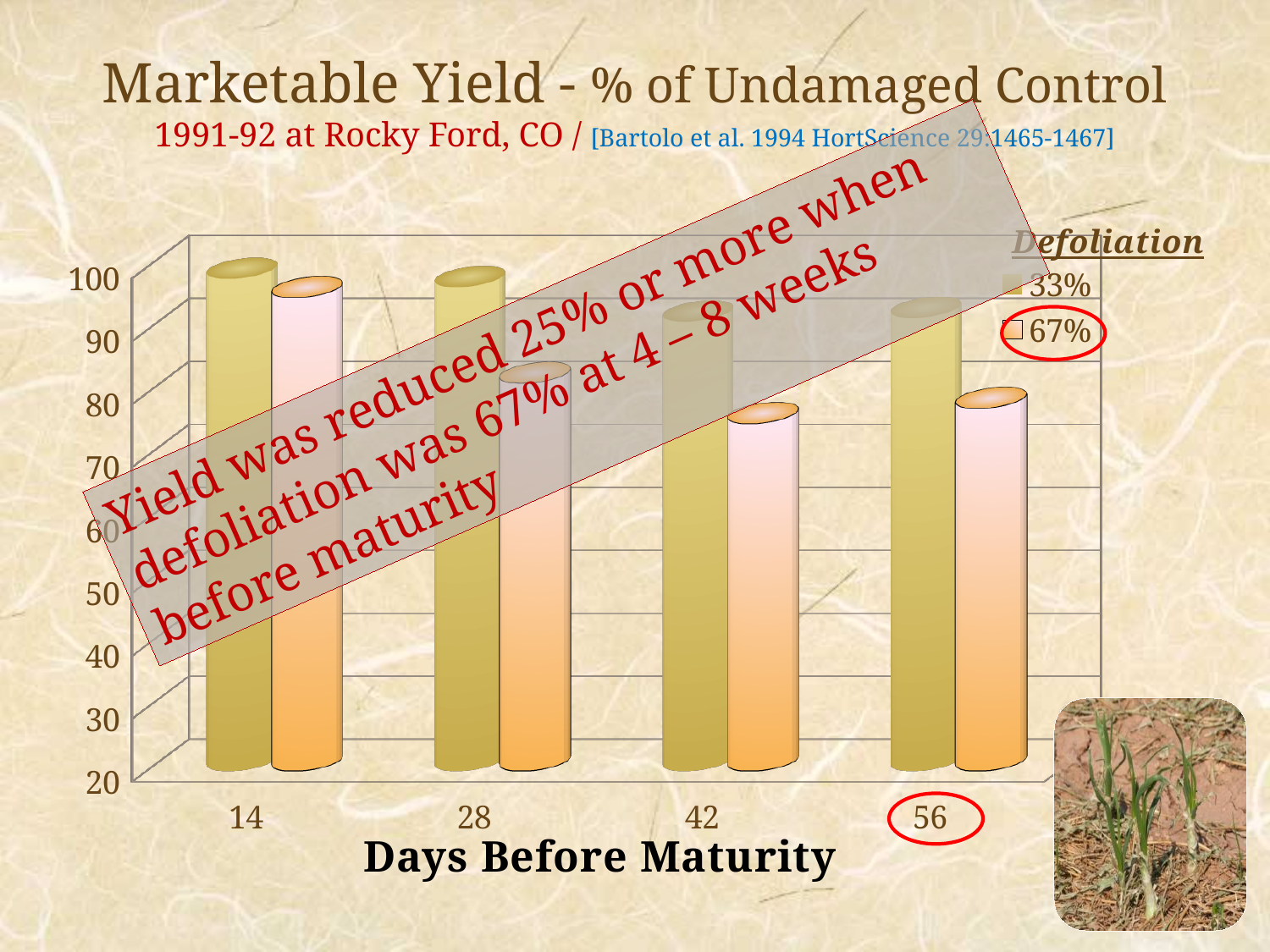
How many series does the Defoliation legend list? 2 Is the value for 67% defoliation at 42 days before maturity greater or less than 90? less For the 67% defoliation series, at which number of days before maturity is the yield highest? 14 At 28 days before maturity, which defoliation level has the higher marketable yield, 33% or 67%? 33% What kind of chart is shown on the slide? bar chart At 42 days before maturity, which defoliation level has the higher marketable yield, 33% or 67%? 33% Is the value for 67% defoliation at 14 days before maturity greater or less than 90? greater Is the value for 67% defoliation at 56 days before maturity greater or less than 90? less What is the title of the legend? Defoliation What is the title of the x axis? Days Before Maturity How many categories (days before maturity) are shown on the x axis? 4